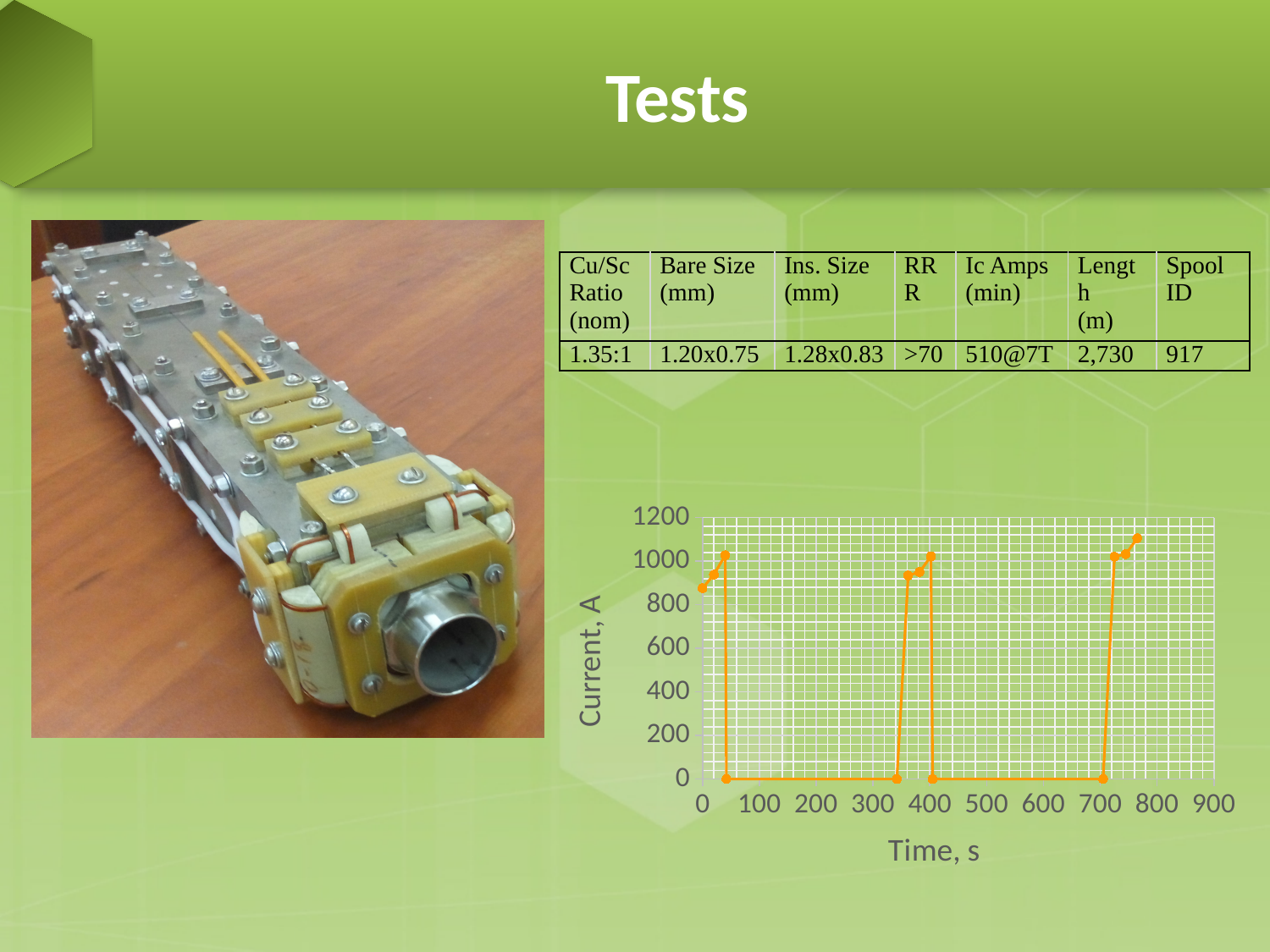
Is the peak current reached in the third ramp (around 750 s) greater or less than 1000 A? greater What is the current value between the ramps (for example at 200 s)? 0 How many separate current ramps (pulses) are plotted on the chart? 3 Is the current at time 0 s greater or less than 1000 A? less What kind of chart is shown on the slide? line chart What is the label of the vertical axis of the chart? Current, A Is the peak current reached in the third ramp (around 750 s) greater or less than 1200 A? less Within each ramp, does the current rise or fall as time increases? rise What is the highest value shown on the horizontal axis of the chart? 900 What is the highest value shown on the vertical axis of the chart? 1200 What is the label of the horizontal axis of the chart? Time, s